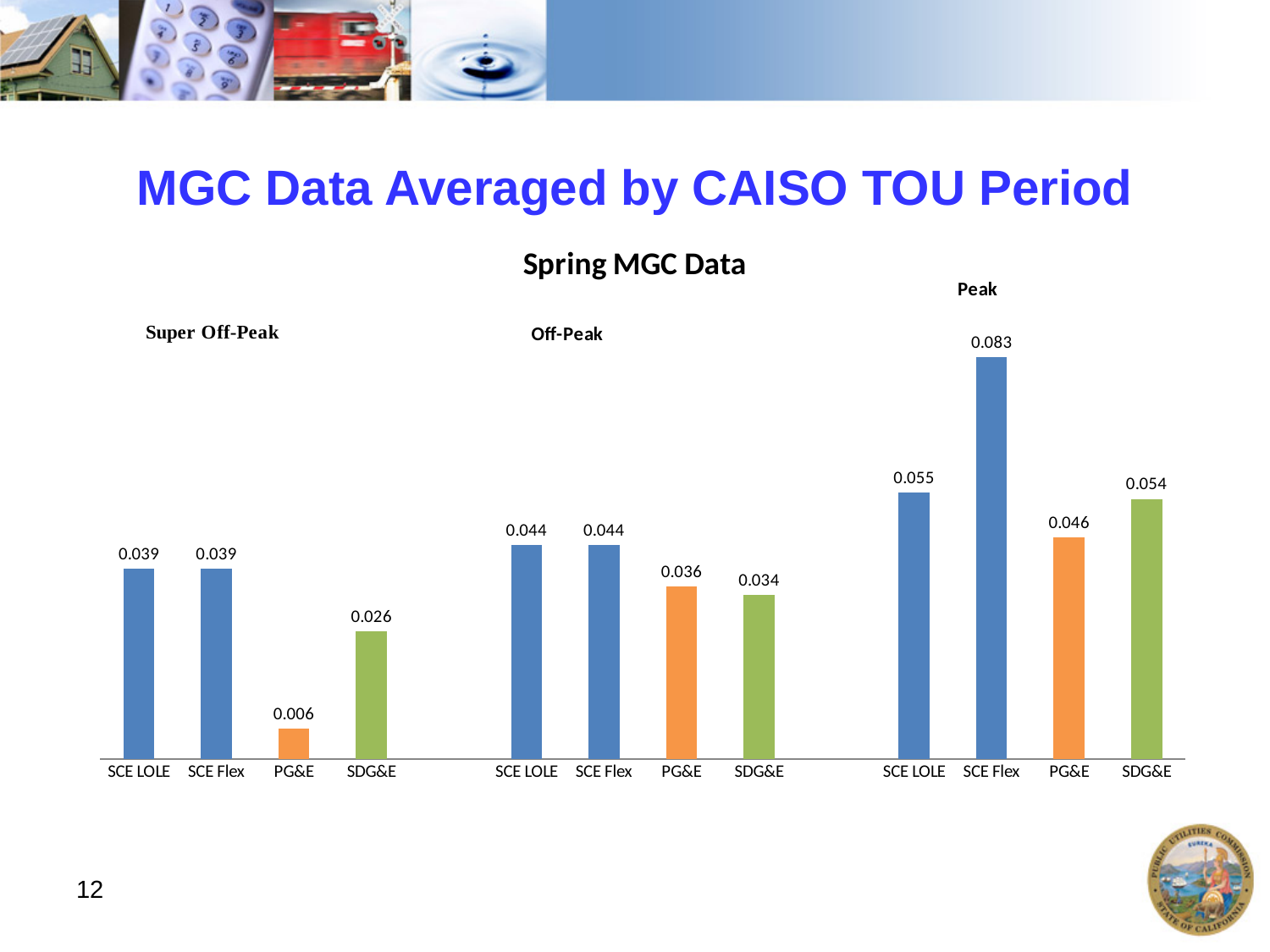
What are the three TOU period groups shown in the Spring MGC Data chart? Super Off-Peak, Off-Peak, Peak What is the difference between the SDG&E and PG&E values in the Super Off-Peak group? 0.020 Which utility has the highest value in the Peak group? SCE Flex What kind of chart is the Spring MGC Data chart? Bar chart What is the difference between the SCE Flex and PG&E values in the Peak group? 0.037 In the Off-Peak group, which is larger, the value for PG&E or the value for SDG&E? PG&E In the Super Off-Peak group, what is the value for PG&E? 0.006 In the Peak group, what is the value for SCE Flex? 0.083 Which utility has the lowest value in the Super Off-Peak group? PG&E In the Off-Peak group, what is the value for SDG&E? 0.034 Which is larger, the SDG&E value in the Peak group or the SDG&E value in the Off-Peak group? Peak How many bars are plotted in the Spring MGC Data chart in total? 12